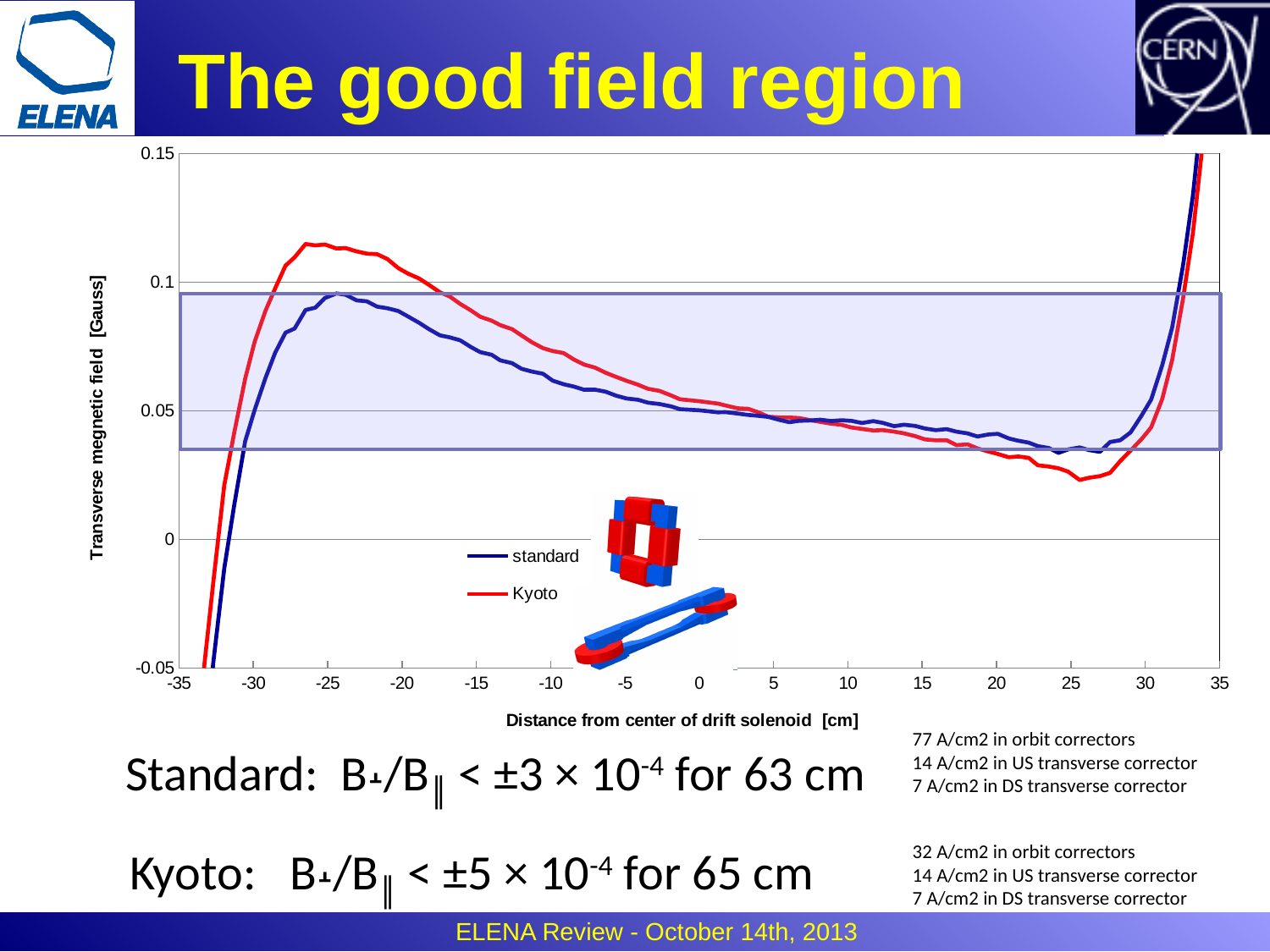
At -20 cm, which series has the larger value, standard or Kyoto? Kyoto What kind of chart is shown on the slide? line chart Between -25 cm and 25 cm, does the standard series rise or fall along the x axis? fall Which series reaches the higher maximum value, standard or Kyoto? Kyoto Is the value of the Kyoto series at 25 cm greater or less than 0.05? less How many series does the chart legend list? 2 At 25 cm, which series has the larger value, standard or Kyoto? standard Which series has the lower minimum value in the region around 25 cm, standard or Kyoto? Kyoto Is the peak value of the Kyoto series greater or less than 0.1? greater Is the peak value of the standard series greater or less than 0.1? less What are the two series named in the chart legend? standard and Kyoto What is the title of the chart's x axis? Distance from center of drift solenoid [cm]